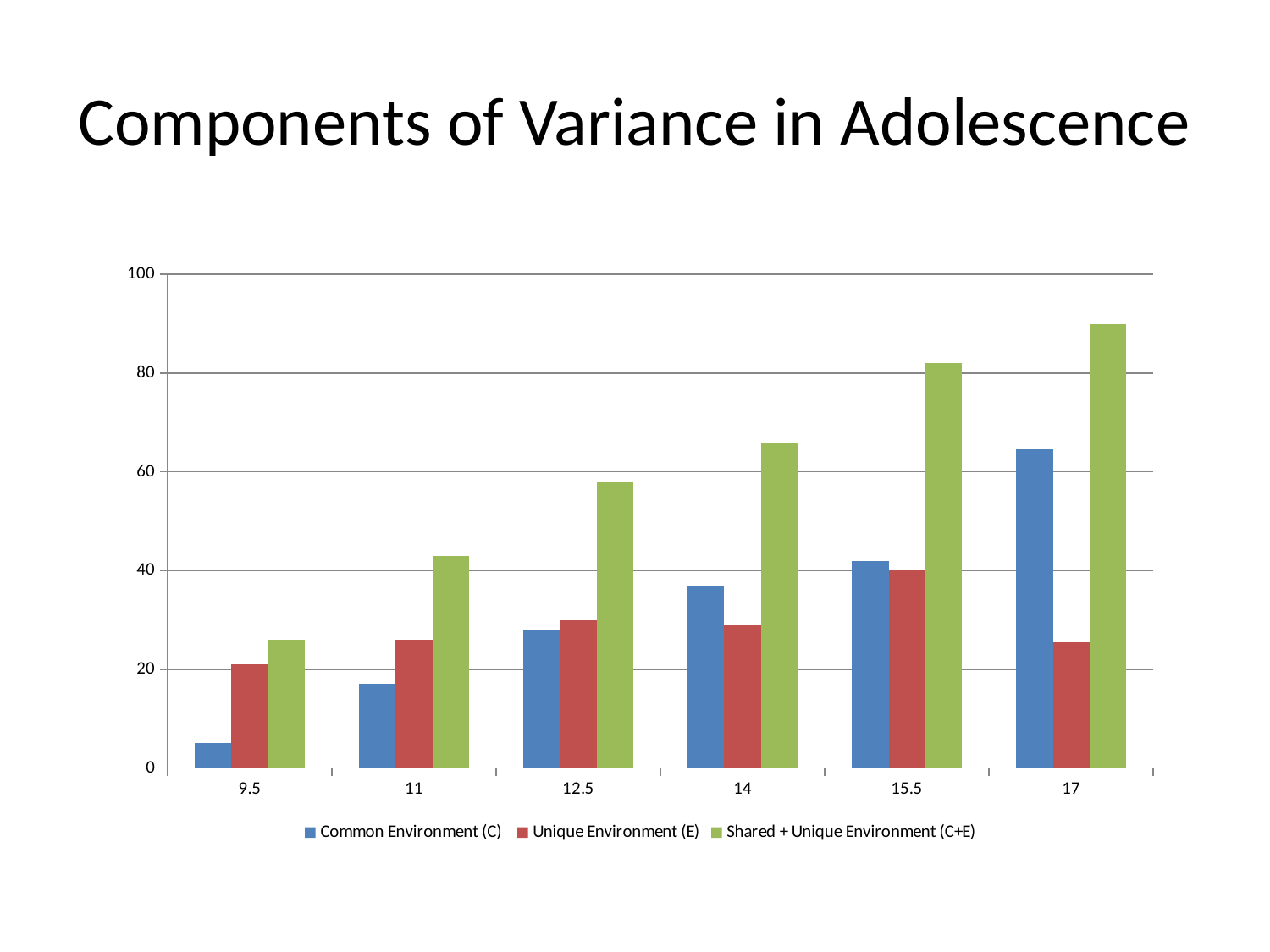
How many age categories are shown on the x axis? 6 Is the Shared + Unique Environment (C+E) value at age 17 greater or less than 80? greater At which age is the Shared + Unique Environment (C+E) value highest? 17 Do the Shared + Unique Environment (C+E) values rise or fall as age increases along the x axis? rise At which age is the Common Environment (C) value lowest? 9.5 At age 17, which is larger: Common Environment (C) or Unique Environment (E)? Common Environment (C) Is the Shared + Unique Environment (C+E) value at age 12.5 greater or less than 60? less What kind of chart is shown on the slide? bar chart Is the Common Environment (C) value at age 9.5 greater or less than 20? less What is the title of the chart on the slide? Components of Variance in Adolescence How many series does the legend list? 3 At which age is the Unique Environment (E) value highest? 15.5